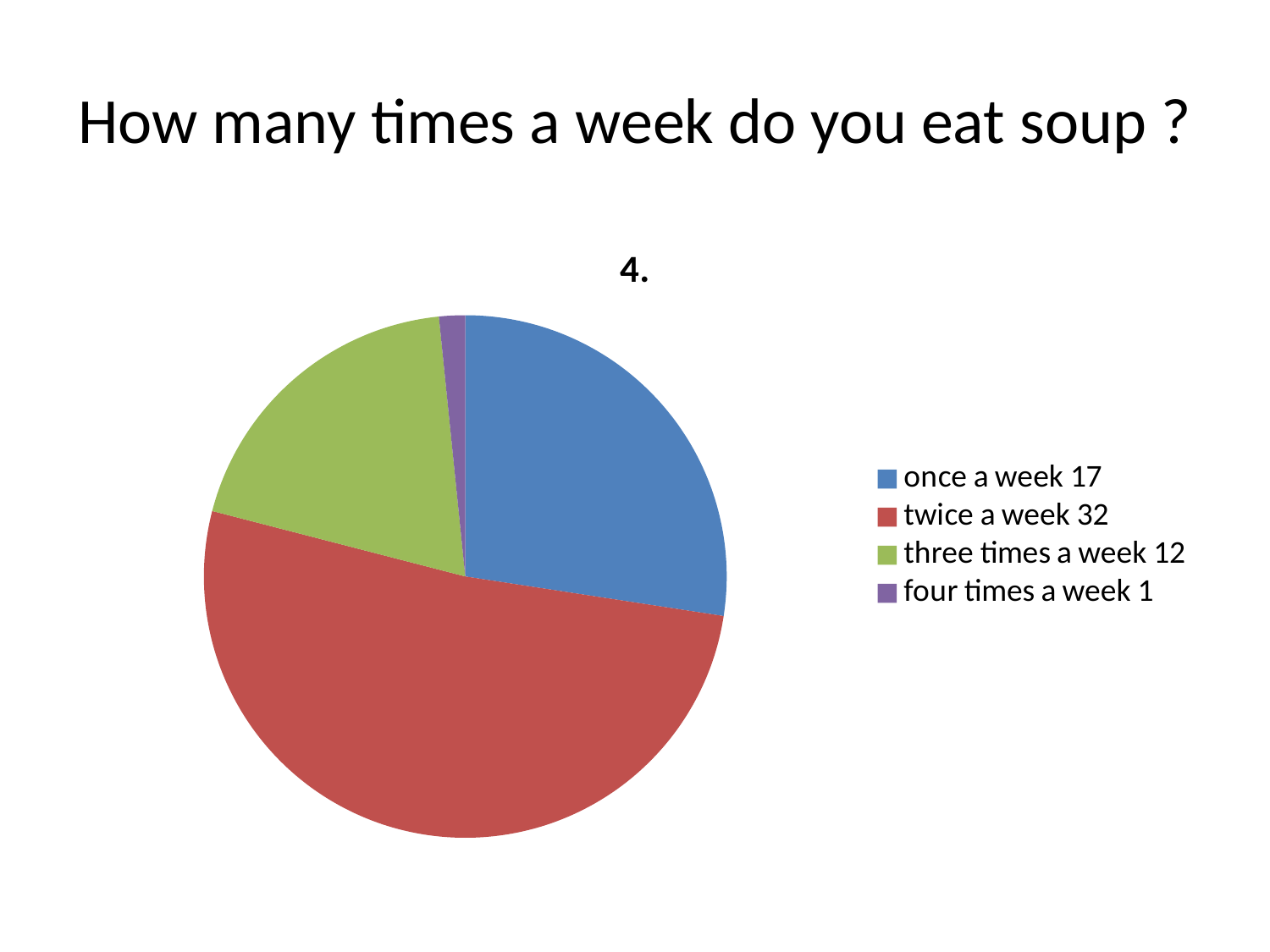
What type of chart is shown on the slide? pie chart Which category has the largest slice of the pie chart? twice a week How many categories does the pie chart have? 4 What is the total of all the values in the pie chart? 62 What is the value for "four times a week" in the pie chart? 1 What is the value for "once a week" in the pie chart? 17 Which is larger, the value for "once a week" or the value for "three times a week"? once a week Which category has the smallest slice of the pie chart? four times a week What is the difference between the values for "twice a week" and "once a week"? 15 What is the value for "three times a week" in the pie chart? 12 What is the difference between the values for "three times a week" and "four times a week"? 11 What is the value for "twice a week" in the pie chart? 32